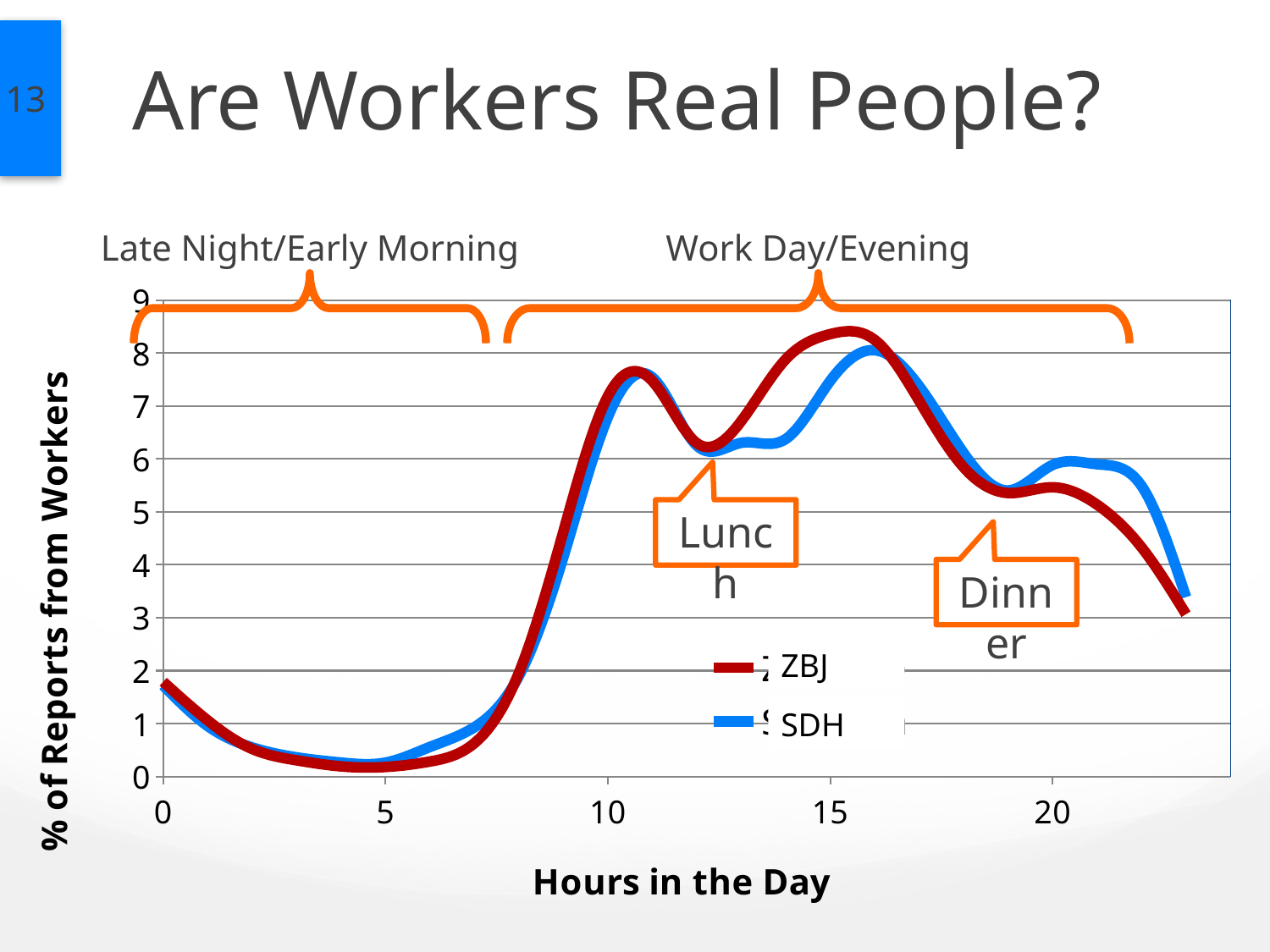
At hour 14, which series has the higher value, ZBJ or SDH? ZBJ Is the SDH value at hour 20 greater or less than 5? greater What is the title of the vertical axis? % of Reports from Workers What kind of chart is shown on the slide? line chart What are the two series named in the legend? ZBJ and SDH Is the SDH value at hour 0 greater or less than 3? less Between hour 5 and hour 10, do the ZBJ values rise or fall? rise Between hour 16 and hour 22, do the ZBJ values rise or fall? fall Is the ZBJ value at hour 15 greater or less than 7? greater How many series does the legend list? 2